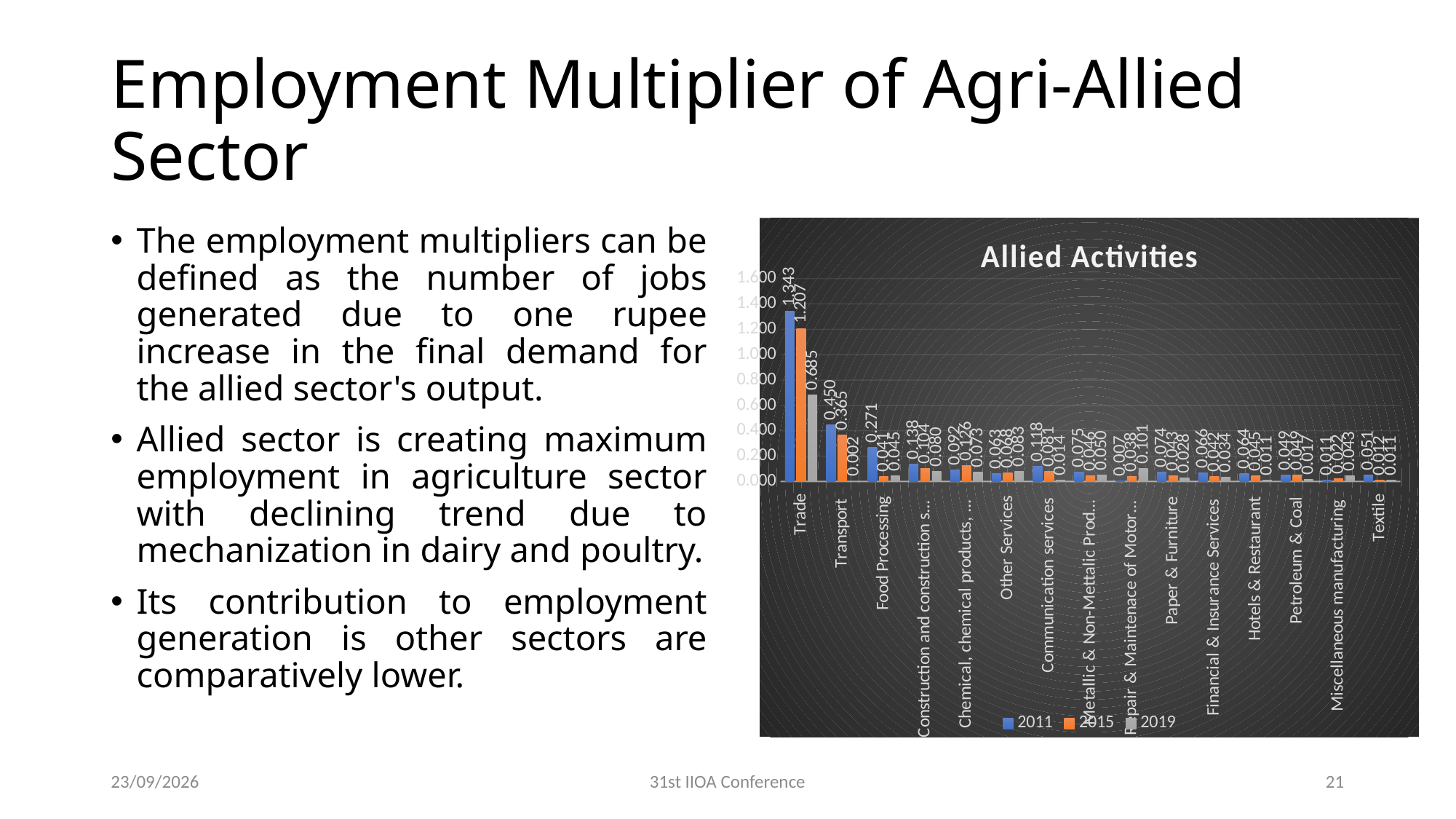
How many categories are shown along the x axis of the Allied Activities chart? 15 In the Allied Activities chart, which is larger for 2011: Trade or Transport? Trade What is the title of the chart on the slide? Allied Activities What is the 2011 value for Food Processing in the Allied Activities chart? 0.271 How many series does the legend of the Allied Activities chart list? 3 What is the 2011 value for Transport in the Allied Activities chart? 0.450 What kind of chart is shown on the slide? bar chart Which category has the highest value in the Allied Activities chart? Trade What is the 2011 value for Trade in the Allied Activities chart? 1.343 What is the difference between the 2011 and 2015 values for Trade in the Allied Activities chart? 0.136 What is the 2019 value for Trade in the Allied Activities chart? 0.685 In the Allied Activities chart, do the values for Trade rise or fall from 2011 to 2019? fall